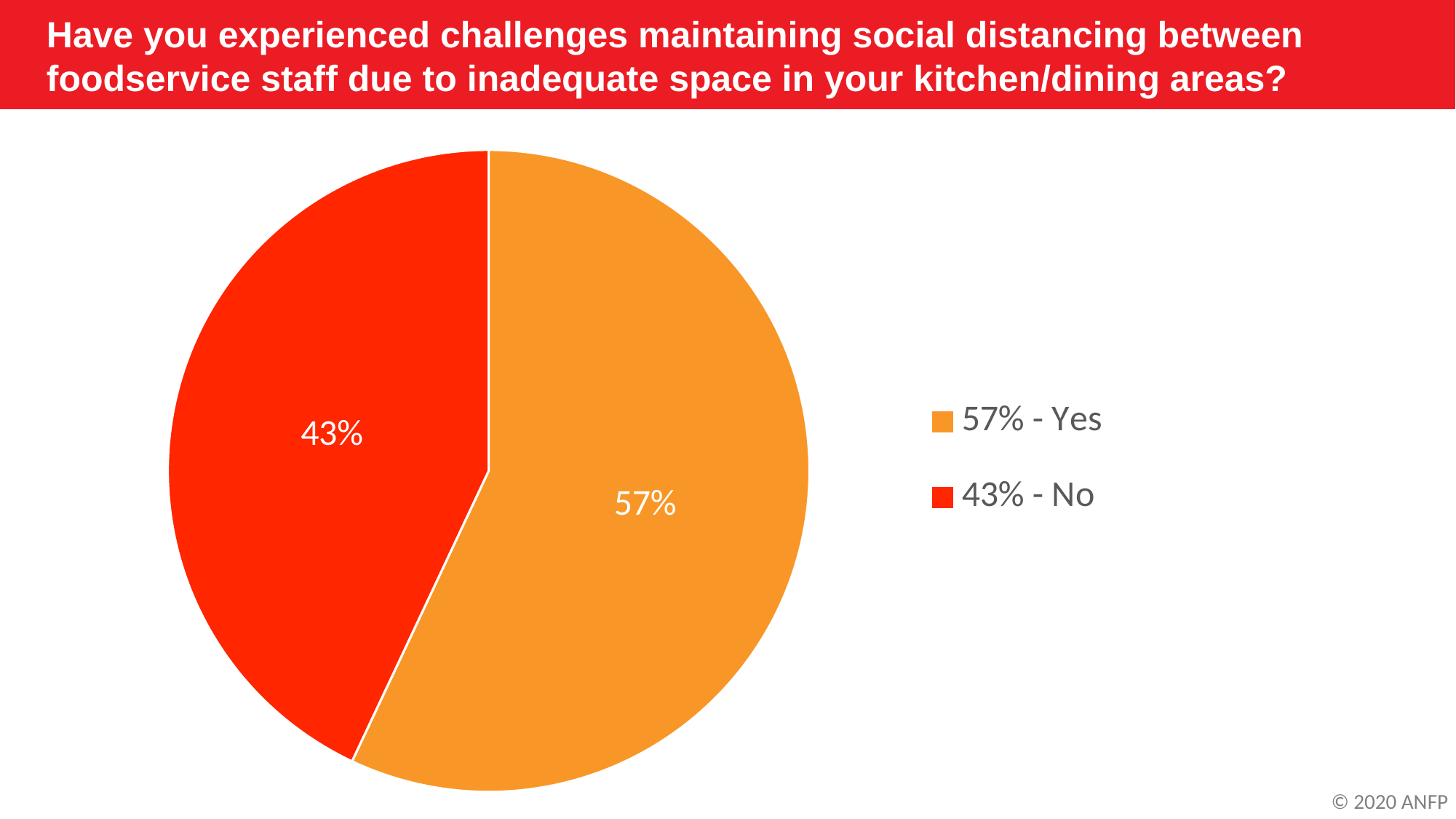
Which is larger, the share for Yes or the share for No? Yes What colour is the Yes slice of the pie? orange What kind of chart is shown on the slide? pie chart What question does the chart title ask? Have you experienced challenges maintaining social distancing between foodservice staff due to inadequate space in your kitchen/dining areas? What percentage of respondents answered Yes? 57% Which response has the largest share of the pie? Yes What is the difference in percentage points between the Yes and No responses? 14 How many slices does the pie chart have? 2 Which response has the smallest share of the pie? No What share of the pie does the No slice represent? 43% What percentage of respondents answered No? 43% How many entries does the legend list? 2